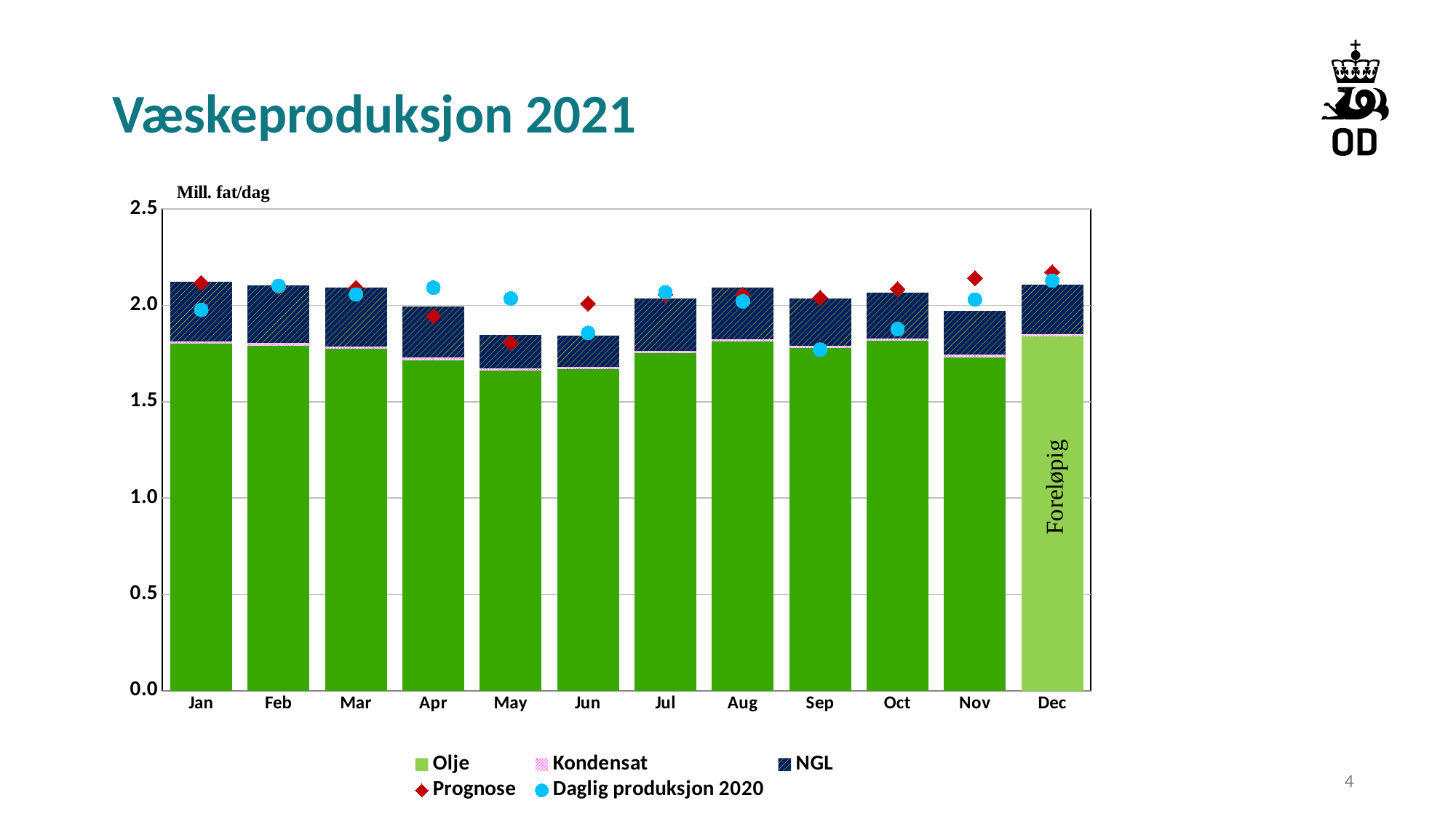
Is the total stacked value for Jan greater or less than 2.0? greater Is the Olje value for Jan greater or less than 1.5? greater Do the total stacked values rise or fall from Jan to May? fall Which has the larger total stacked value, Jul or Nov? Jul Which month's bar is labelled "Foreløpig"? Dec Is the total stacked value for Nov greater or less than 2.0? less How many series does the legend list? 5 What kind of chart is shown on the slide? Stacked bar chart How many months (categories) are shown on the x axis? 12 Which has the larger total stacked value, Jan or May? Jan What unit is shown above the y axis? Mill. fat/dag